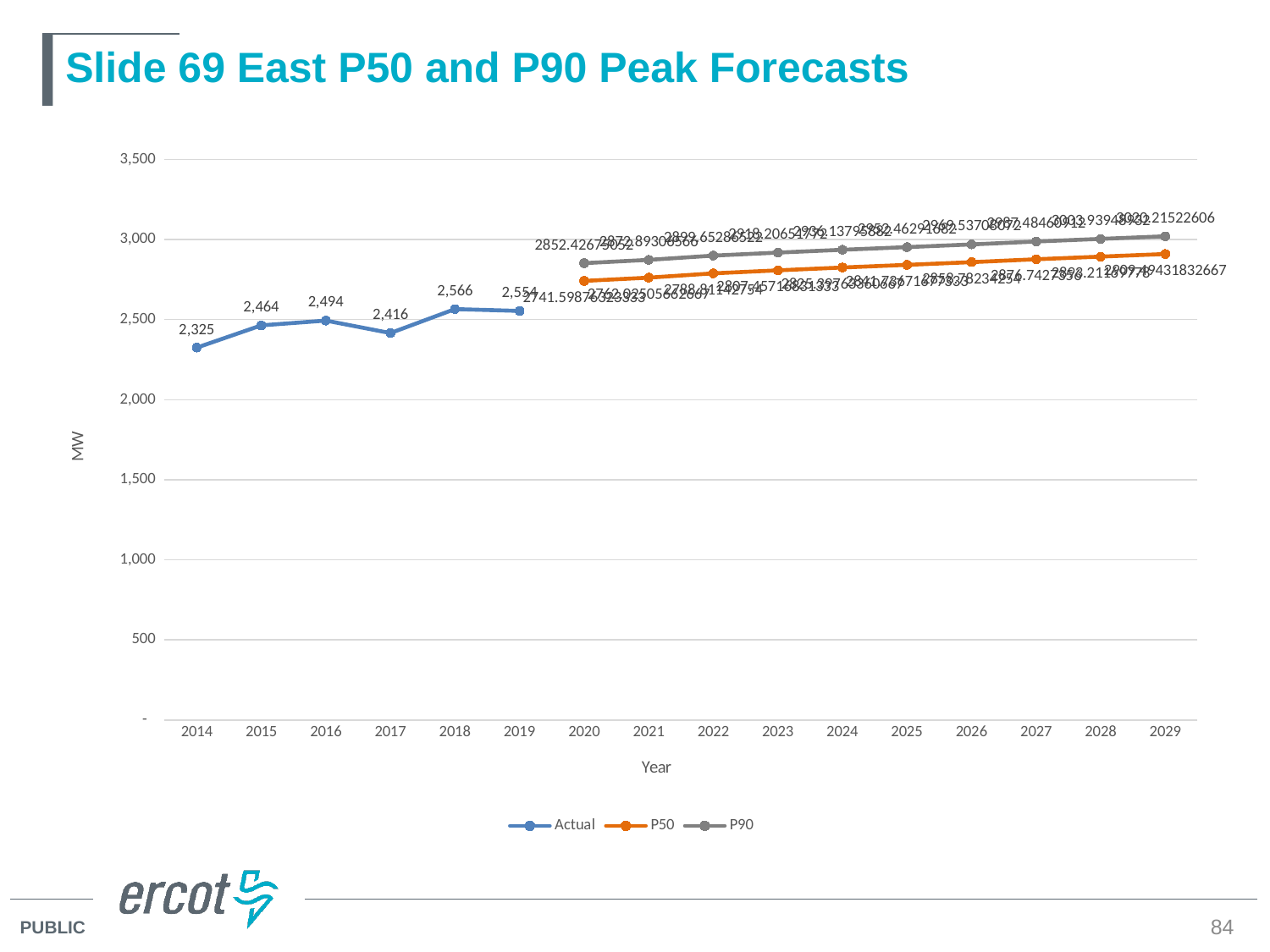
Does the P90 series rise or fall from 2020 to 2029? rise What is the difference between the Actual values for 2018 and 2014? 241 How many years are shown on the x axis? 16 Is the P50 value for 2020 greater or less than 3,000? less How many series does the legend list? 3 In which year is the Actual series highest? 2018 What is the Actual value for 2018? 2,566 Is the P90 value for 2029 greater or less than 3,000? greater What is the Actual value for 2014? 2,325 What kind of chart is shown on the slide? line chart Which year has the larger Actual value, 2016 or 2017? 2016 In which year is the Actual series lowest? 2014